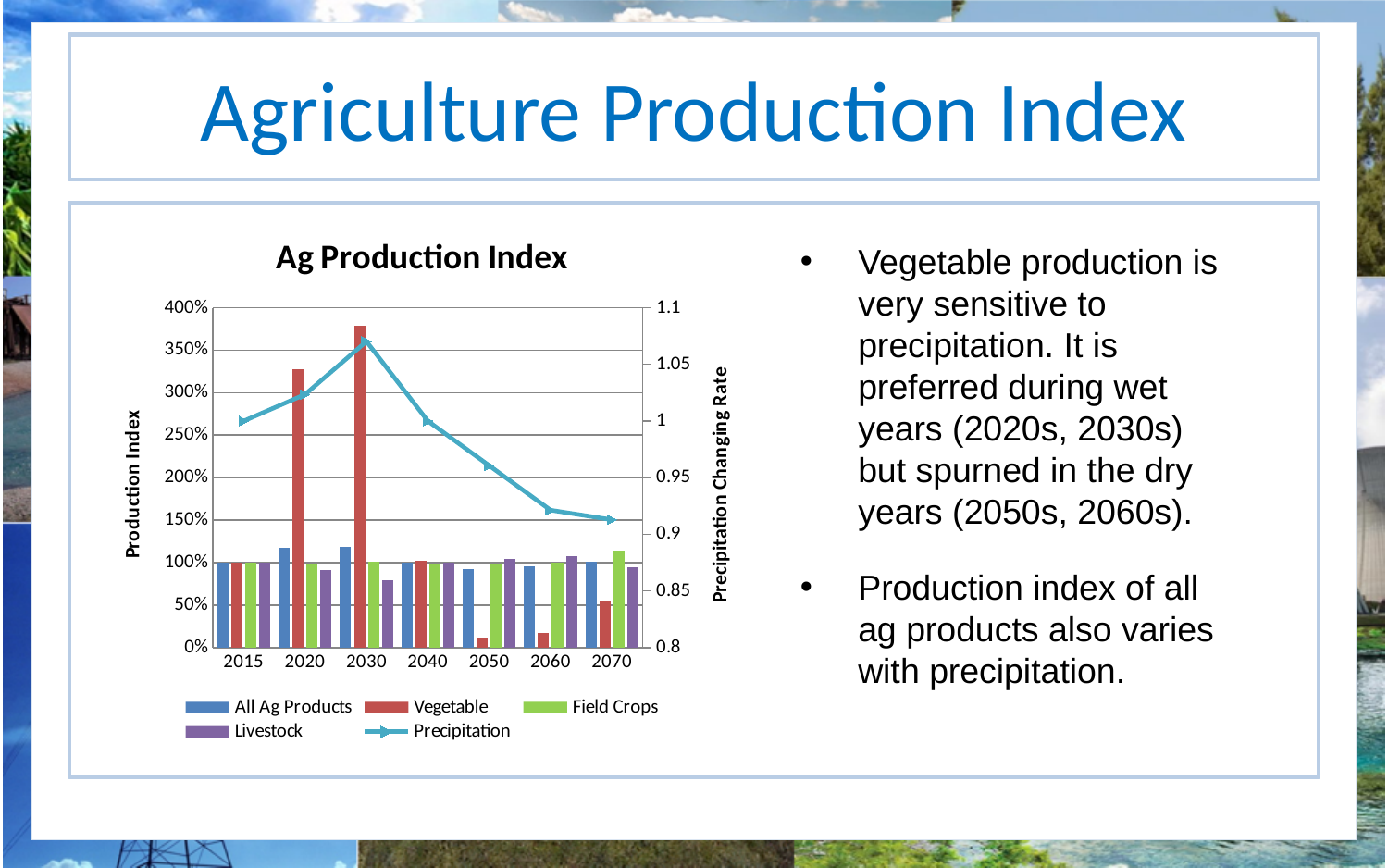
Is the Precipitation value for 2070 greater or less than 0.95? less Is the Precipitation value for 2030 greater or less than 1.05? greater In which year does the Precipitation line reach its highest value? 2030 Is the Vegetable production index for 2050 greater or less than 50%? less How many years are shown on the x axis of the Ag Production Index chart? 7 In which year is the Vegetable production index highest? 2030 Which is larger, the Vegetable production index in 2020 or in 2030? 2030 Does the Precipitation line rise or fall from 2030 to 2070? fall What is the title of the right-hand vertical axis of the chart? Precipitation Changing Rate What kind of chart is shown on the slide? A bar chart combined with a line How many series does the legend of the Ag Production Index chart list? 5